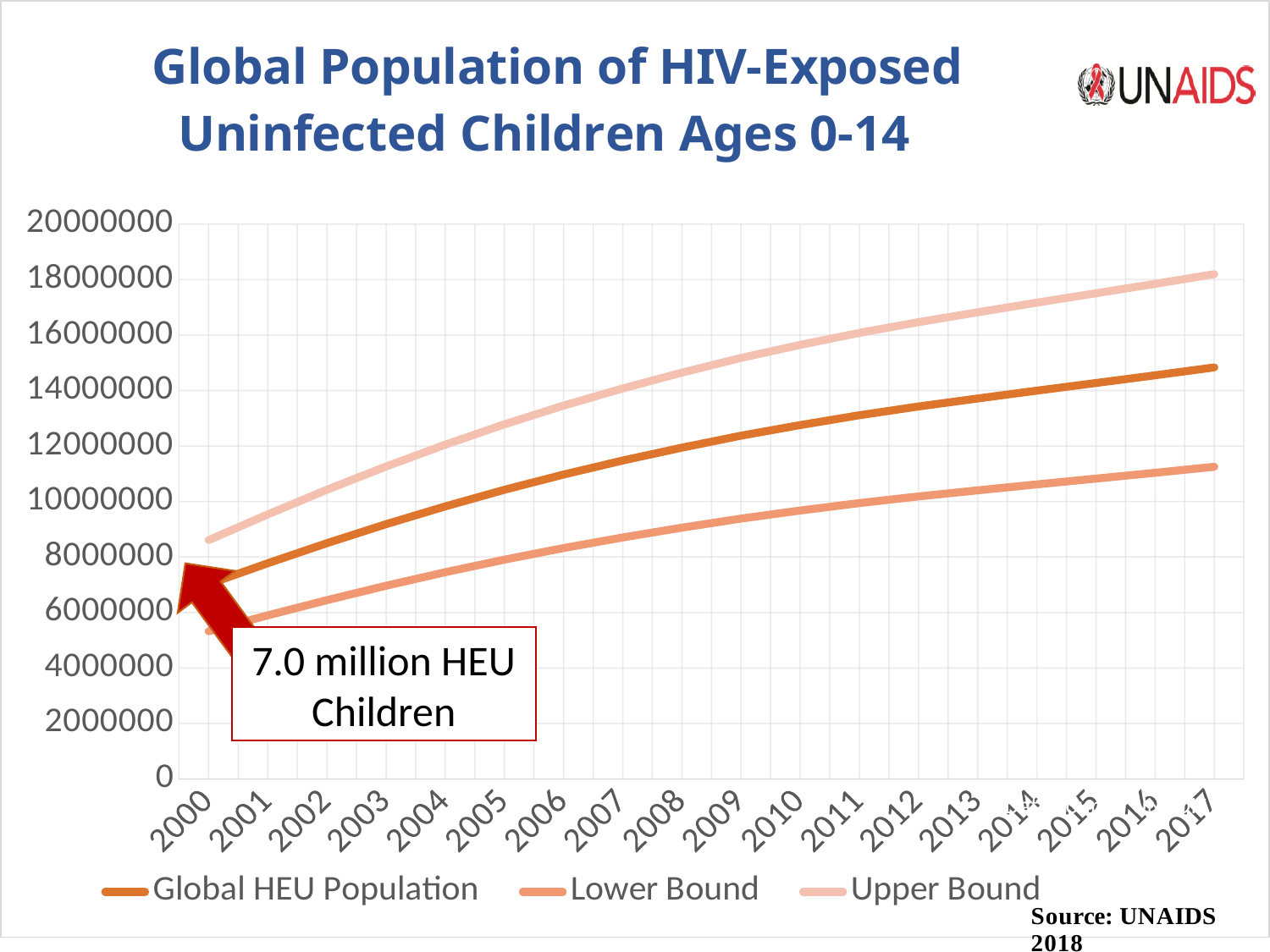
Does the Global HEU Population rise or fall from 2000 to 2017? rise How many series does the legend list? 3 Which series has the lowest value in 2017? Lower Bound How many years are shown along the x axis? 18 According to the annotation, what was the global HEU population in 2000? 7.0 million Is the Global HEU Population value for 2017 greater or less than 16000000? less What is the title of the chart? Global Population of HIV-Exposed Uninfected Children Ages 0-14 Which series has the highest value in 2017? Upper Bound Is the Upper Bound value for 2017 greater or less than 16000000? greater Is the Lower Bound value for 2017 greater or less than 10000000? greater In 2010, which is larger: the Upper Bound or the Lower Bound? Upper Bound What kind of chart is shown on the slide? line chart